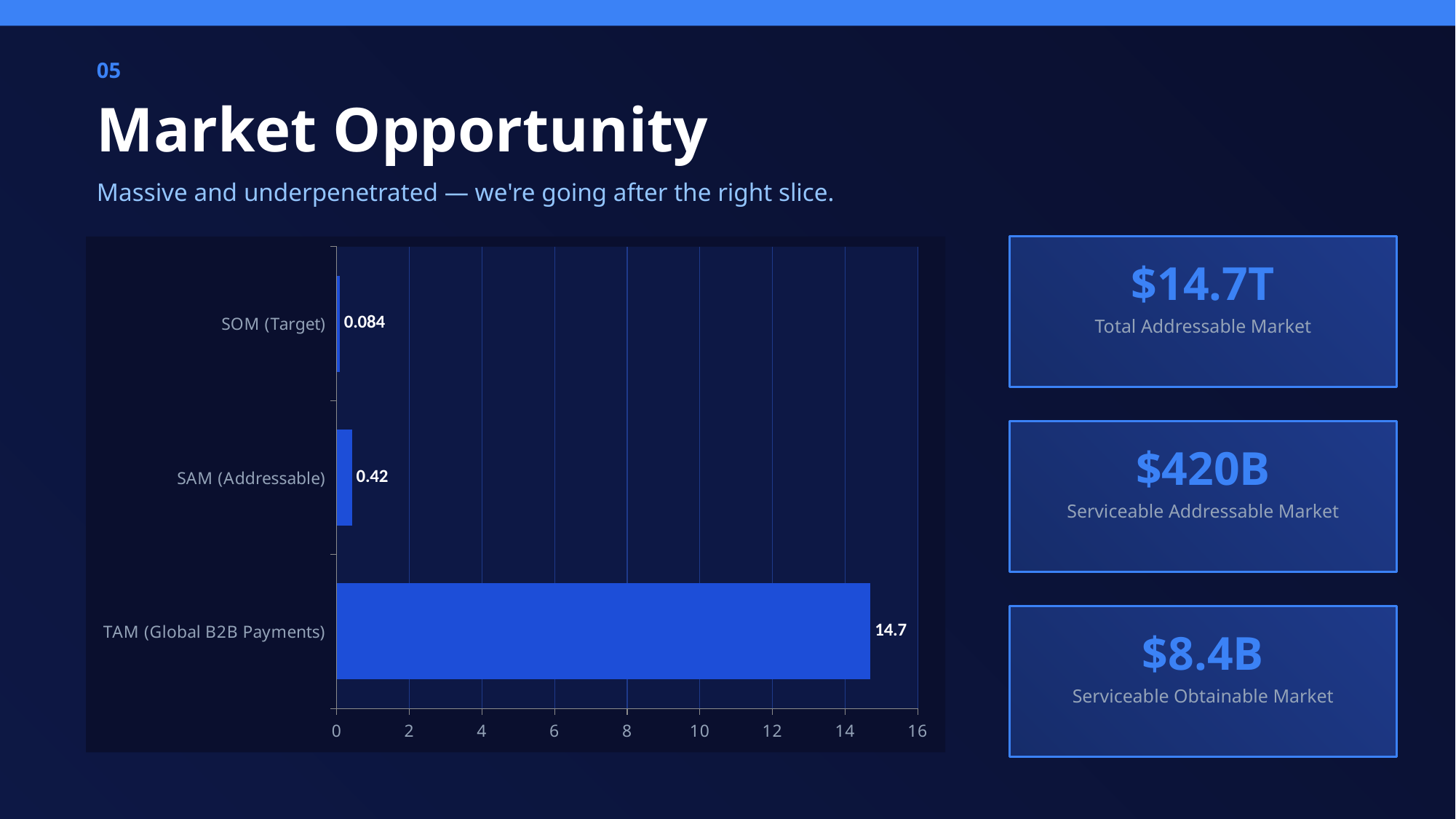
Is the value for TAM (Global B2B Payments) greater or less than 14? greater What is the difference between the values for TAM (Global B2B Payments) and SAM (Addressable)? 14.28 How many categories are shown in the chart? 3 Which category has the highest value? TAM (Global B2B Payments) What is the value for TAM (Global B2B Payments)? 14.7 What is the difference between the values for SAM (Addressable) and SOM (Target)? 0.336 What is the maximum value shown on the x axis of the chart? 16 What is the value for SAM (Addressable)? 0.42 What is the value for SOM (Target)? 0.084 Which category has the lowest value? SOM (Target) What kind of chart is shown on the slide? Bar chart Which is larger, the value for SAM (Addressable) or the value for SOM (Target)? SAM (Addressable)